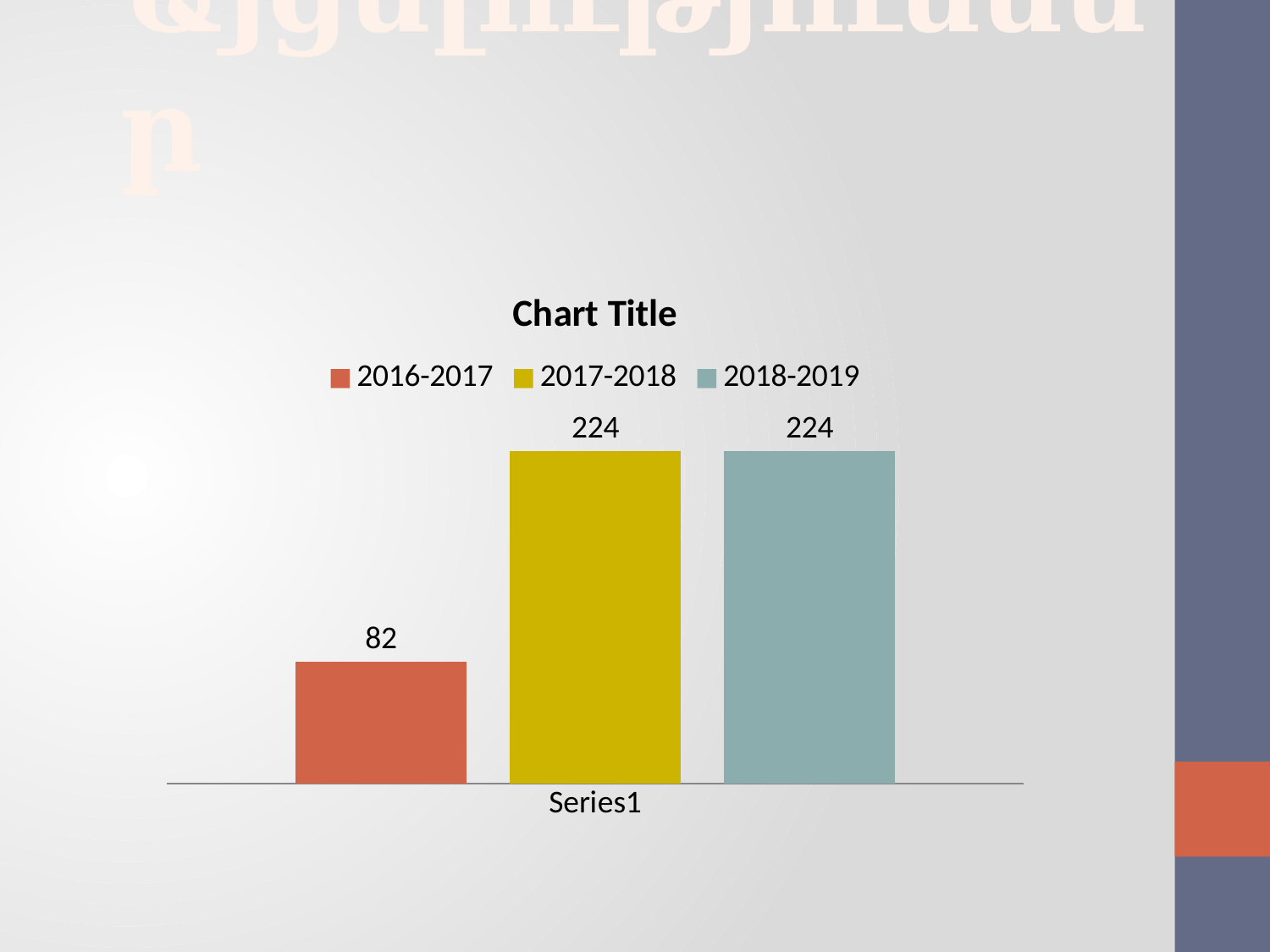
Which is larger, the value for 2016-2017 or the value for 2018-2019? 2018-2019 What is the difference between the values for 2017-2018 and 2016-2017? 142 What kind of chart is shown on the slide? Bar chart What is the title of the chart? Chart Title What is the value for 2017-2018? 224 Do 2017-2018 and 2018-2019 have the same value? Yes Which series has the lowest value? 2016-2017 What is the value for 2016-2017? 82 How many series does the legend list? 3 What is the value for 2018-2019? 224 How many bars are plotted in the chart? 3 What is the label on the category axis below the bars? Series1